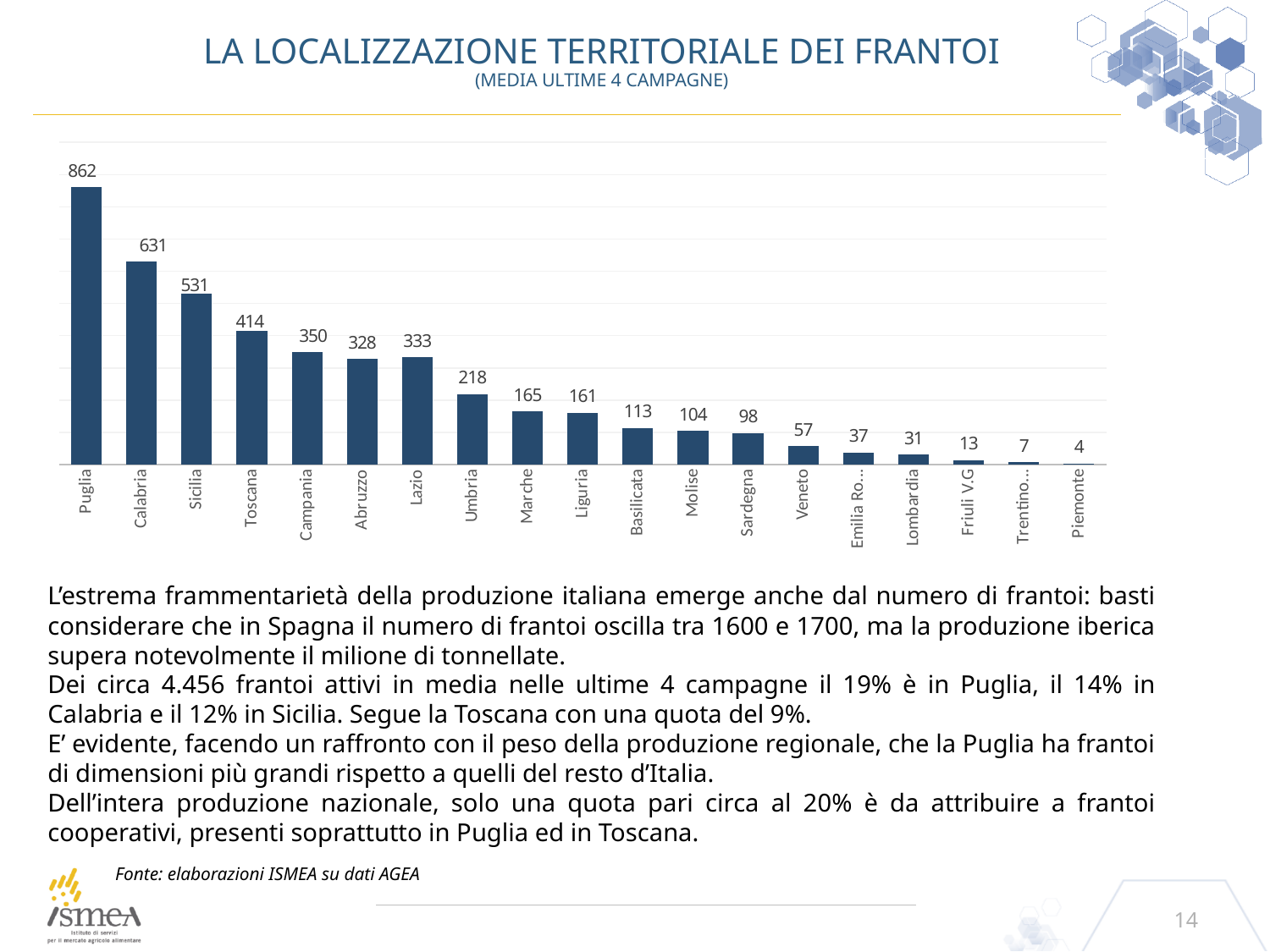
How many regions are shown on the chart? 19 What is the difference between the values for Umbria and Marche? 53 What is the value for Sardegna? 98 What is the subtitle shown under the chart title? (MEDIA ULTIME 4 CAMPAGNE) What is the value for Lombardia? 31 Which region has the highest value? Puglia What is the value for Puglia? 862 Which is larger, the value for Abruzzo or the value for Lazio? Lazio Which region has the lowest value? Piemonte What is the value for Toscana? 414 What kind of chart is shown on the slide? Bar chart What is the difference between the values for Puglia and Calabria? 231